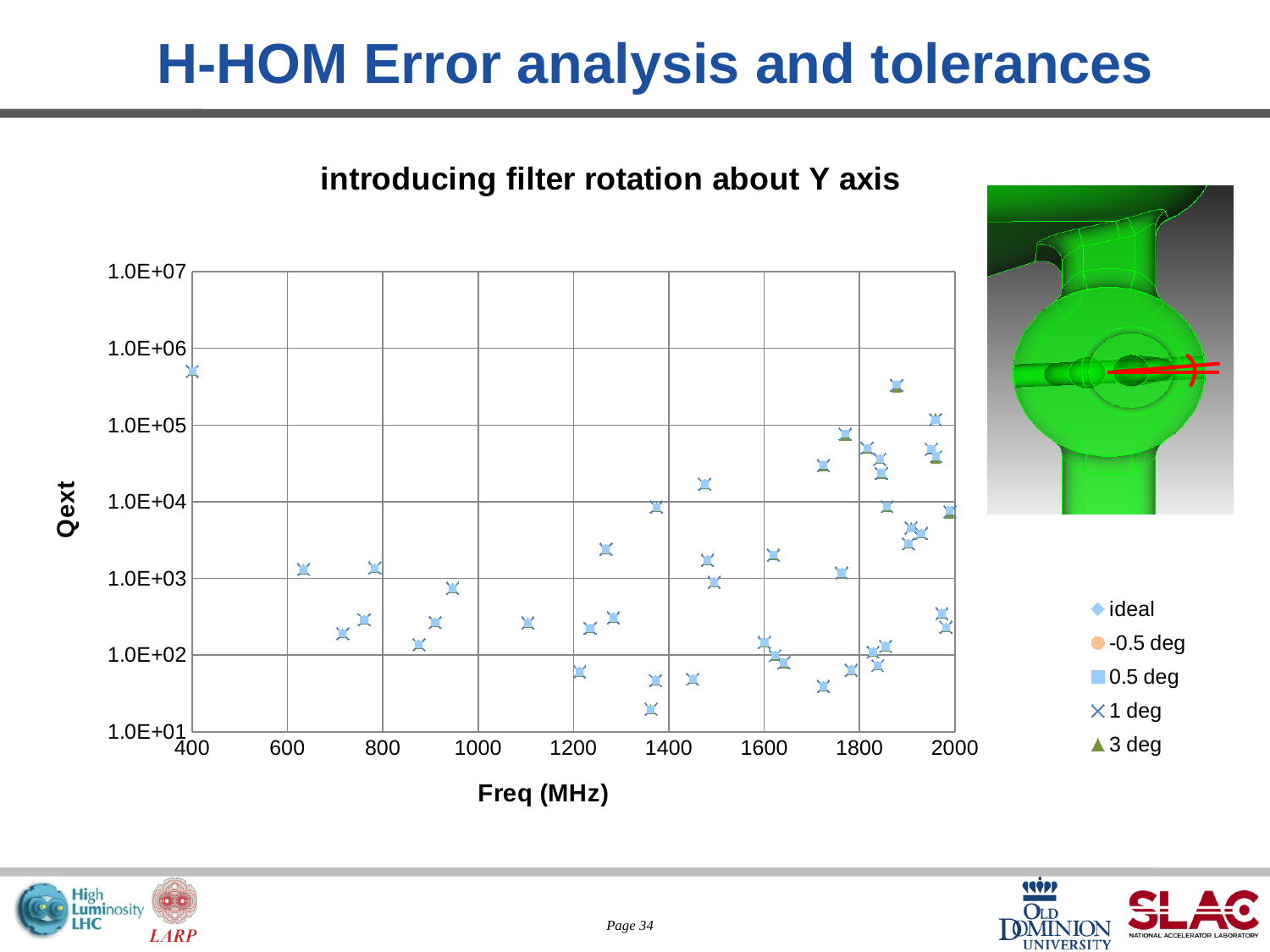
Is the Qext value of the point at 400 MHz greater or less than 1.0E+05? greater What are the series names listed in the chart legend? ideal, -0.5 deg, 0.5 deg, 1 deg, 3 deg Is the Qext value of the point near 1100 MHz greater or less than 1.0E+03? less Is the Qext value of the point near 880 MHz greater or less than 1.0E+03? less What kind of chart is shown on the slide? scatter chart What is the title of the chart? introducing filter rotation about Y axis How many series does the chart legend list? 5